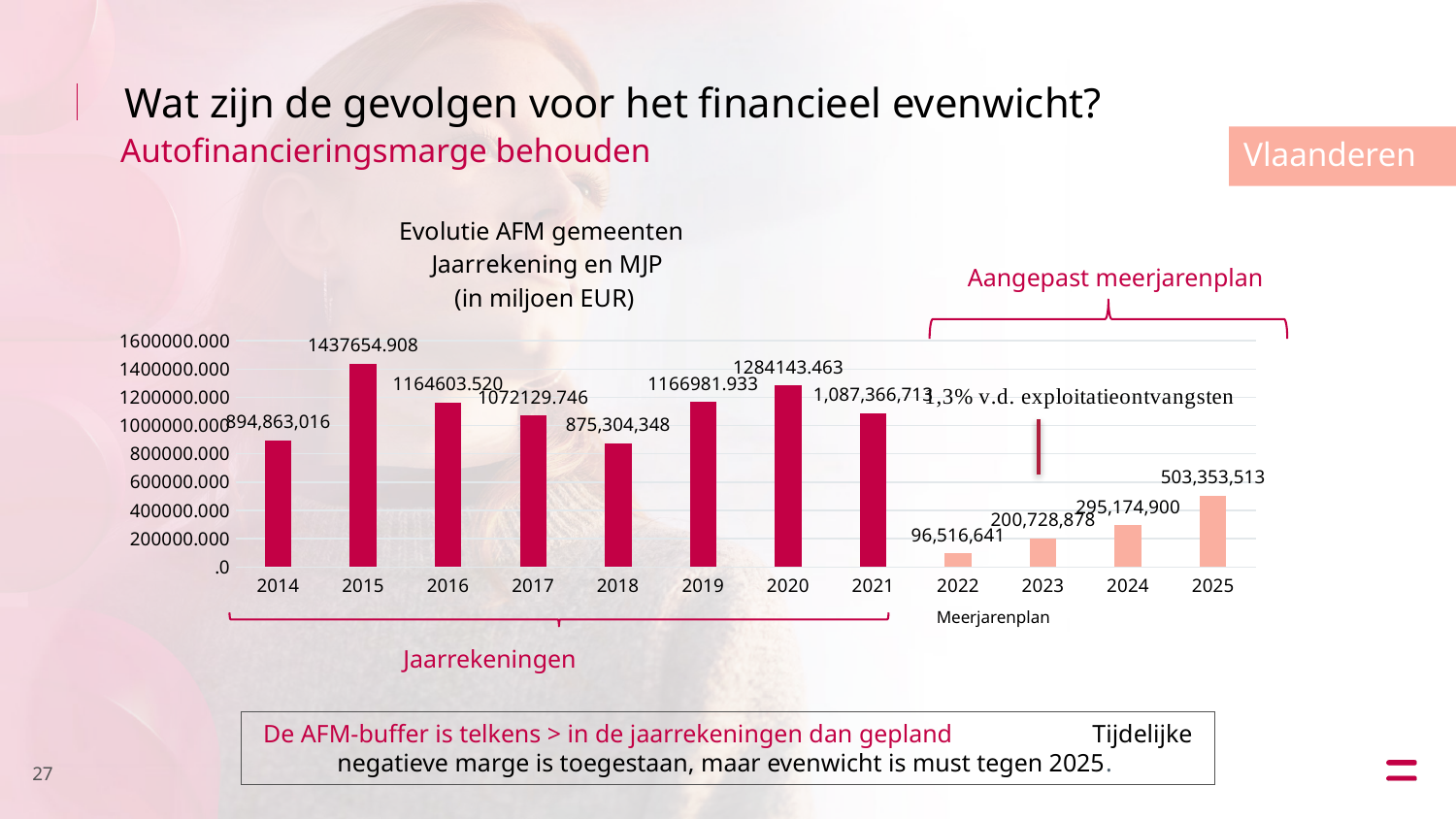
What kind of chart is shown on the slide? Bar chart What is the value shown for 2015? 1437654.908 What is the value shown for 2020? 1284143.463 How many years are shown on the x axis of the chart? 12 Is the value for 2021 greater or less than 1000000.000? greater Which year has the larger value, 2014 or 2018? 2014 What is the value shown for 2022? 96,516,641 What is the value shown for 2025? 503,353,513 What is the value shown for 2018? 875,304,348 Which year has the lowest value in the chart? 2022 Which year has the highest value in the chart? 2015 Do the values rise or fall from 2022 to 2025? Rise